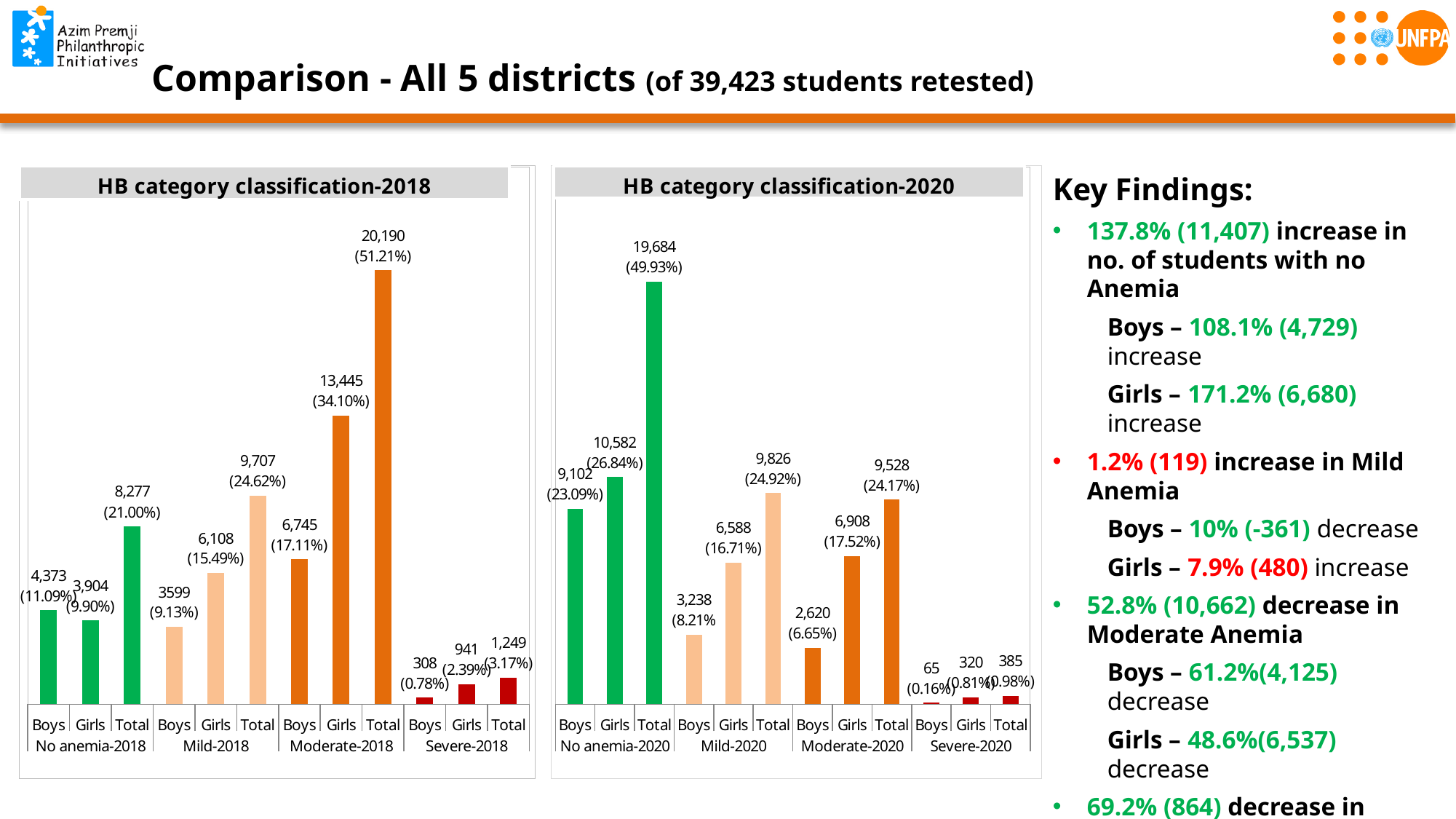
How many bars are plotted in the HB category classification-2018 chart? 12 In the HB category classification-2020 chart, what is the value for Girls in No anemia-2020? 10,582 In the HB category classification-2018 chart, what is the value for Total in Moderate-2018? 20,190 What is the title of the left chart on the slide? HB category classification-2018 In the HB category classification-2020 chart, what percentage is shown for Boys in Severe-2020? 0.16% In the HB category classification-2018 chart, which is larger: Girls in Mild-2018 or Boys in Moderate-2018? Boys in Moderate-2018 In the HB category classification-2018 chart, what is the difference between the Girls and Boys values in Moderate-2018? 6,700 In the HB category classification-2018 chart, which bar has the highest value? Total, Moderate-2018 What type of chart is the HB category classification-2020 chart? Bar chart In the HB category classification-2020 chart, which bar has the lowest value? Boys, Severe-2020 In the HB category classification-2020 chart, what is the difference between the Total values for Mild-2020 and Moderate-2020? 298 In the HB category classification-2020 chart, which is larger: the Total for No anemia-2020 or the Total for Moderate-2020? Total for No anemia-2020